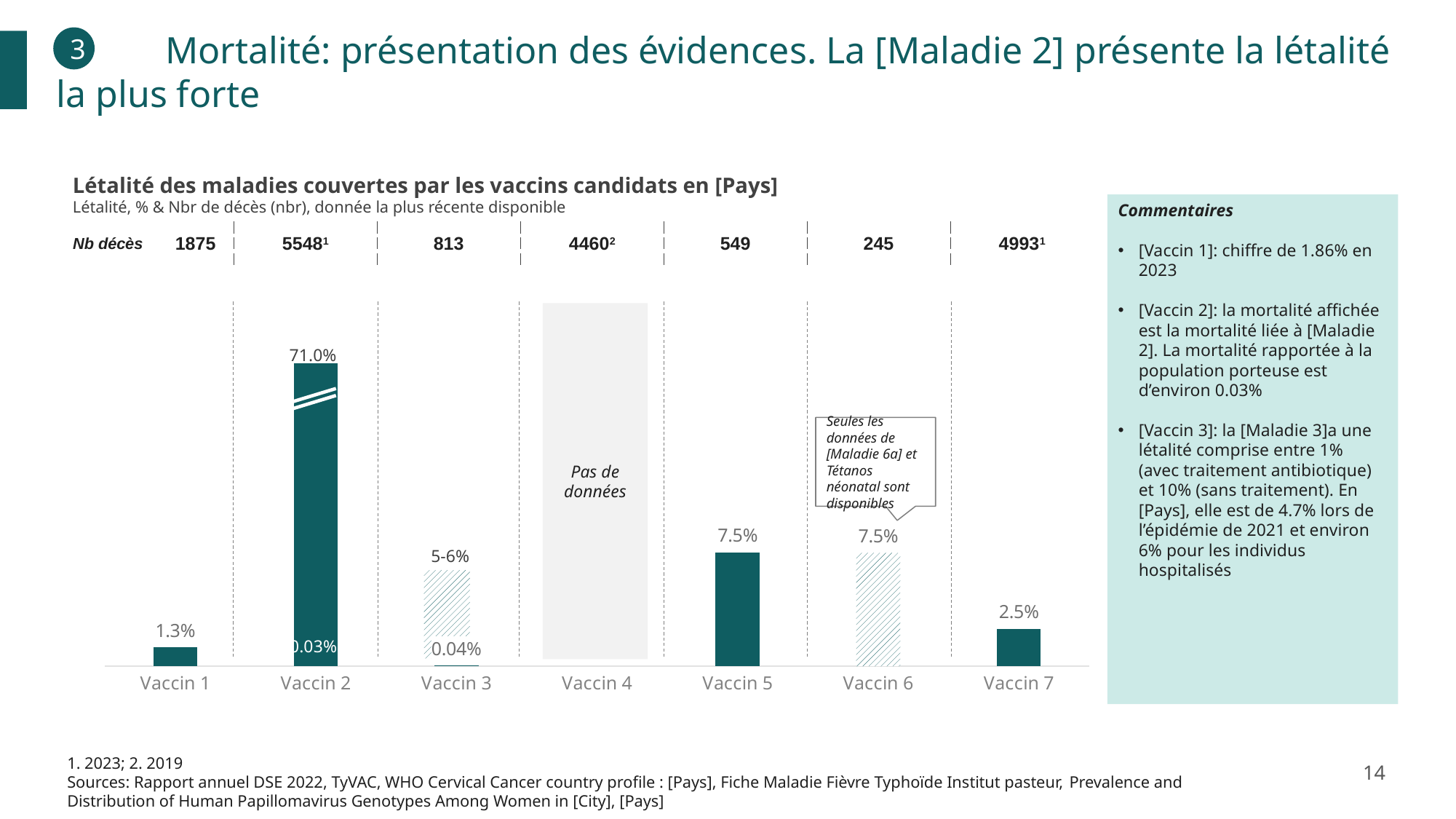
What is the difference in lethality between Vaccin 5 and Vaccin 7? 5.0% What kind of chart is used to show the lethality of the diseases? Bar chart What is the lethality value shown for Vaccin 1? 1.3% What is the number of deaths (Nb décès) shown for Vaccin 3? 813 Which vaccine category has the lowest number of deaths (Nb décès)? Vaccin 6 Which vaccine category has the highest number of deaths (Nb décès)? Vaccin 2 Which has a larger lethality value, Vaccin 1 or Vaccin 7? Vaccin 7 What is the number of deaths (Nb décès) shown for Vaccin 6? 245 Which vaccine category has the highest lethality bar? Vaccin 2 What is the lethality value shown for Vaccin 5? 7.5% What is the lethality value shown for Vaccin 7? 2.5% What is the lethality value shown for Vaccin 2? 71.0%